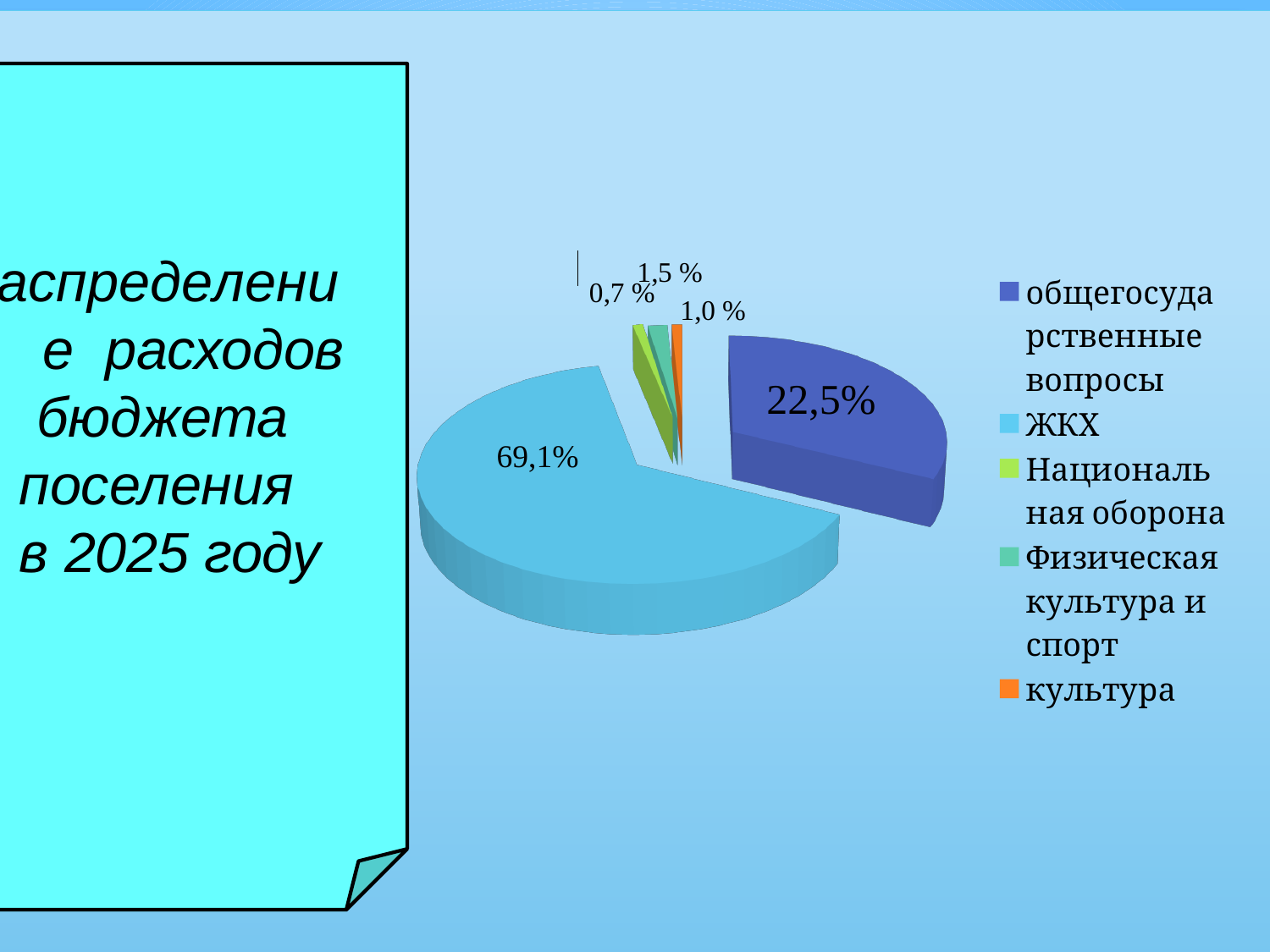
Is the share for ЖКХ greater or less than 50%? greater Which is larger: the share for ЖКХ or the share for общегосударственные вопросы? ЖКХ What type of chart is shown on the slide? Pie chart What share of the budget expenditure goes to общегосударственные вопросы? 22,5% Which category is shown in orange in the legend? культура Which colour represents ЖКХ in the legend? Light blue By how many percentage points does the ЖКХ share exceed the общегосударственные вопросы share? 46,6 Which category has the largest share of the pie? ЖКХ What is the smallest percentage value labelled on the pie chart? 0,7 % How many categories does the legend of the pie chart list? 5 What share of the budget expenditure goes to ЖКХ? 69,1%